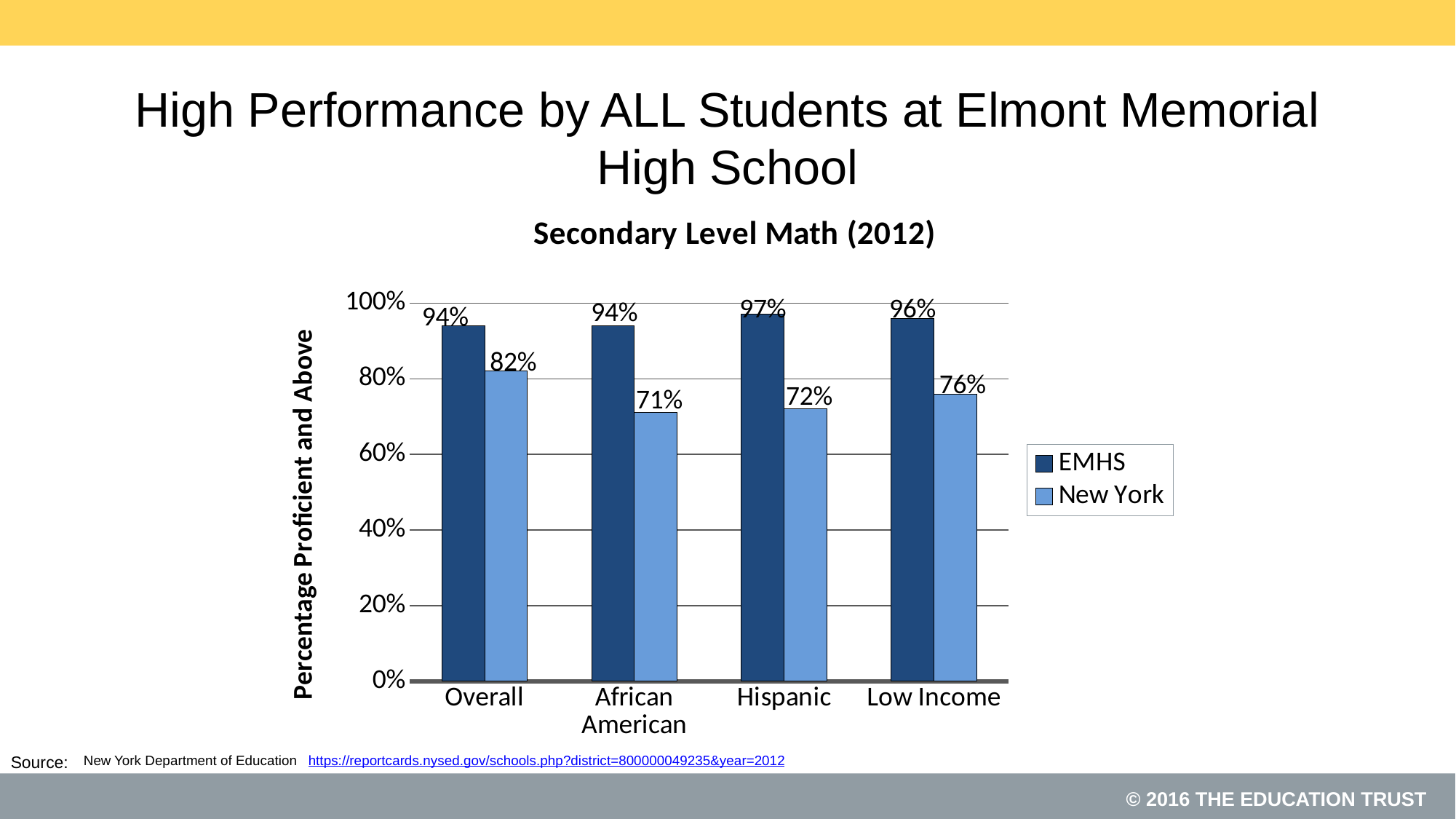
How many series does the legend list? 2 What is the EMHS value for Low Income students? 96% What kind of chart is shown on the slide? Bar chart What is the title of the chart? Secondary Level Math (2012) How many categories are shown on the x axis? 4 What is the New York value for the Overall category? 82% What is the difference between the EMHS and New York values for Low Income students? 20% What is the New York value for African American students? 71% Which category has the lowest New York value? African American Which is larger for Hispanic students, the EMHS value or the New York value? EMHS Which category has the highest EMHS value? Hispanic What is the EMHS value for Hispanic students? 97%